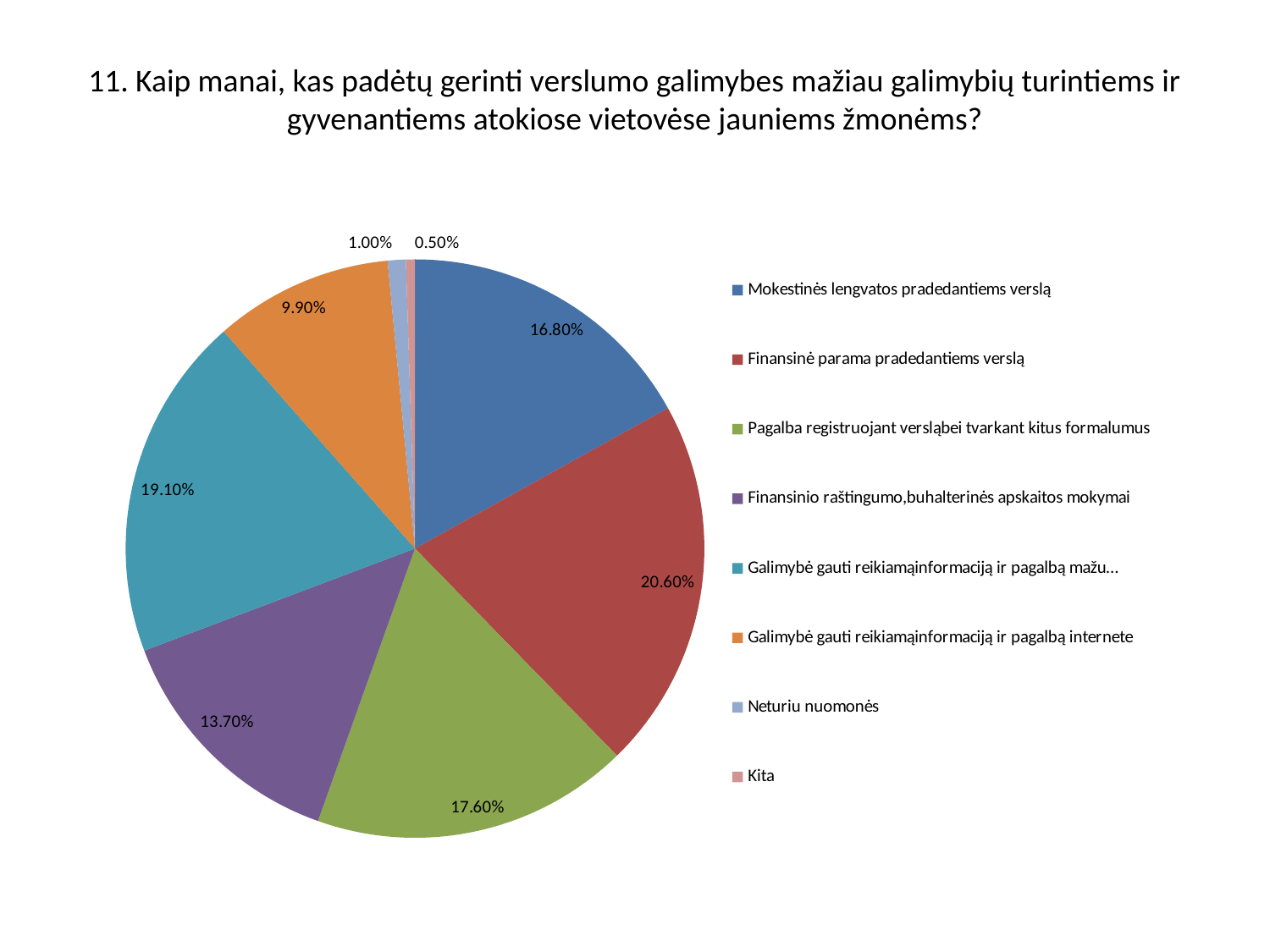
What type of chart is shown on the slide? pie chart How many slices does the pie chart have? 8 What percentage is shown for "Finansinė parama pradedantiems verslą"? 20.60% What percentage is shown for "Kita"? 0.50% What colour is the slice for "Neturiu nuomonės"? light blue Which category has the largest share of the pie? Finansinė parama pradedantiems verslą What percentage is shown for "Galimybė gauti reikiamą informaciją ir pagalbą internete"? 9.90% What percentage is shown for "Mokestinės lengvatos pradedantiems verslą"? 16.80% What is the difference between the shares for "Finansinė parama pradedantiems verslą" and "Pagalba registruojant verslą bei tvarkant kitus formalumus"? 3.00% Which is larger: the share for "Mokestinės lengvatos pradedantiems verslą" or the share for "Pagalba registruojant verslą bei tvarkant kitus formalumus"? Pagalba registruojant verslą bei tvarkant kitus formalumus What percentage is shown for "Finansinio raštingumo,buhalterinės apskaitos mokymai"? 13.70% Which category has the smallest share of the pie? Kita